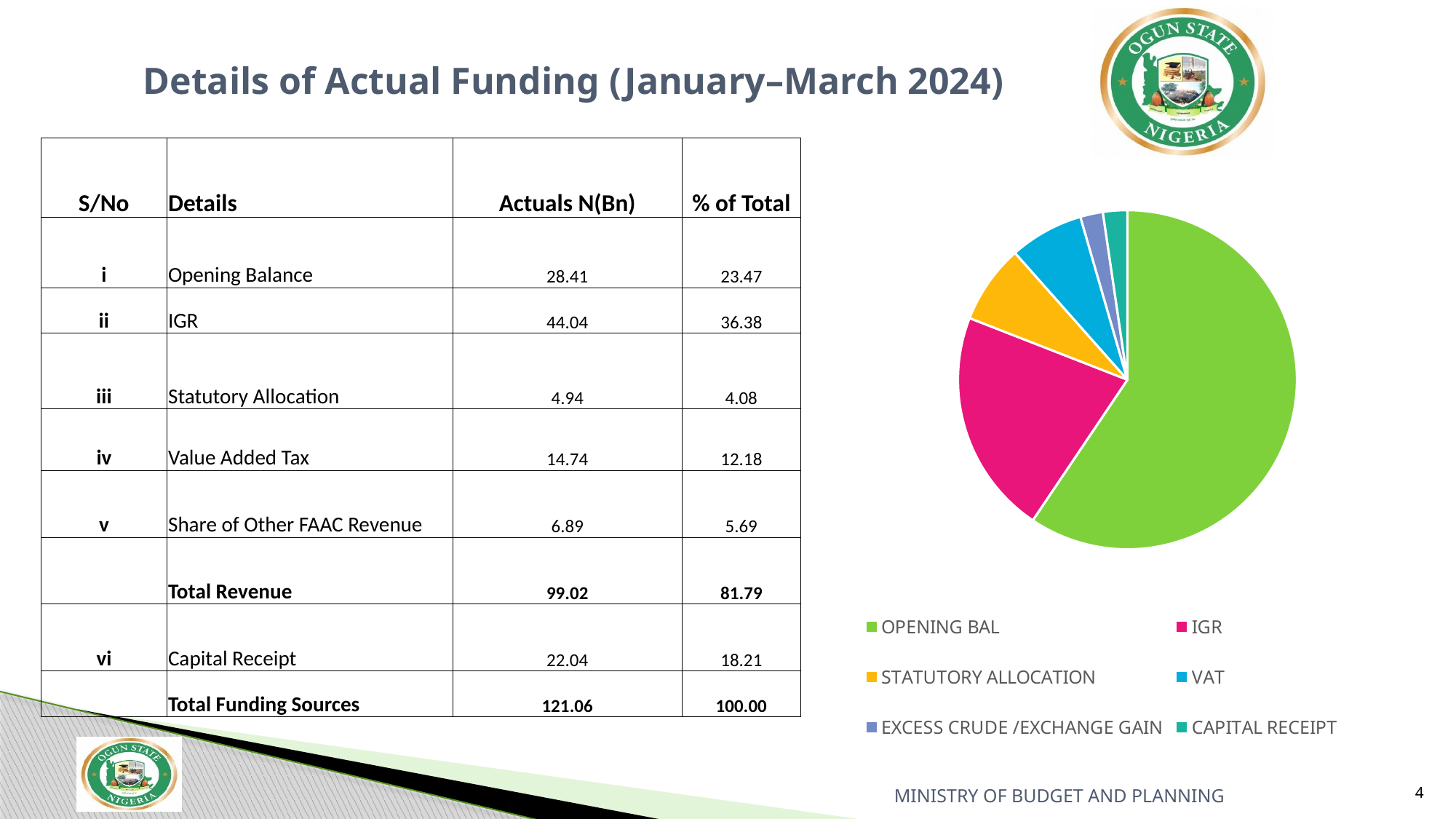
What colour is the IGR slice in the pie chart? pink In the pie chart, which slice is larger: IGR or STATUTORY ALLOCATION? IGR Does the OPENING BAL slice take up more or less than half of the pie chart? more How many entries does the pie chart's legend list? 6 In the pie chart, which slice is larger: STATUTORY ALLOCATION or CAPITAL RECEIPT? STATUTORY ALLOCATION What colour is the OPENING BAL slice in the pie chart? green What kind of chart is shown on the slide? pie chart Which category has the largest slice in the pie chart? OPENING BAL How many slices does the pie chart have? 6